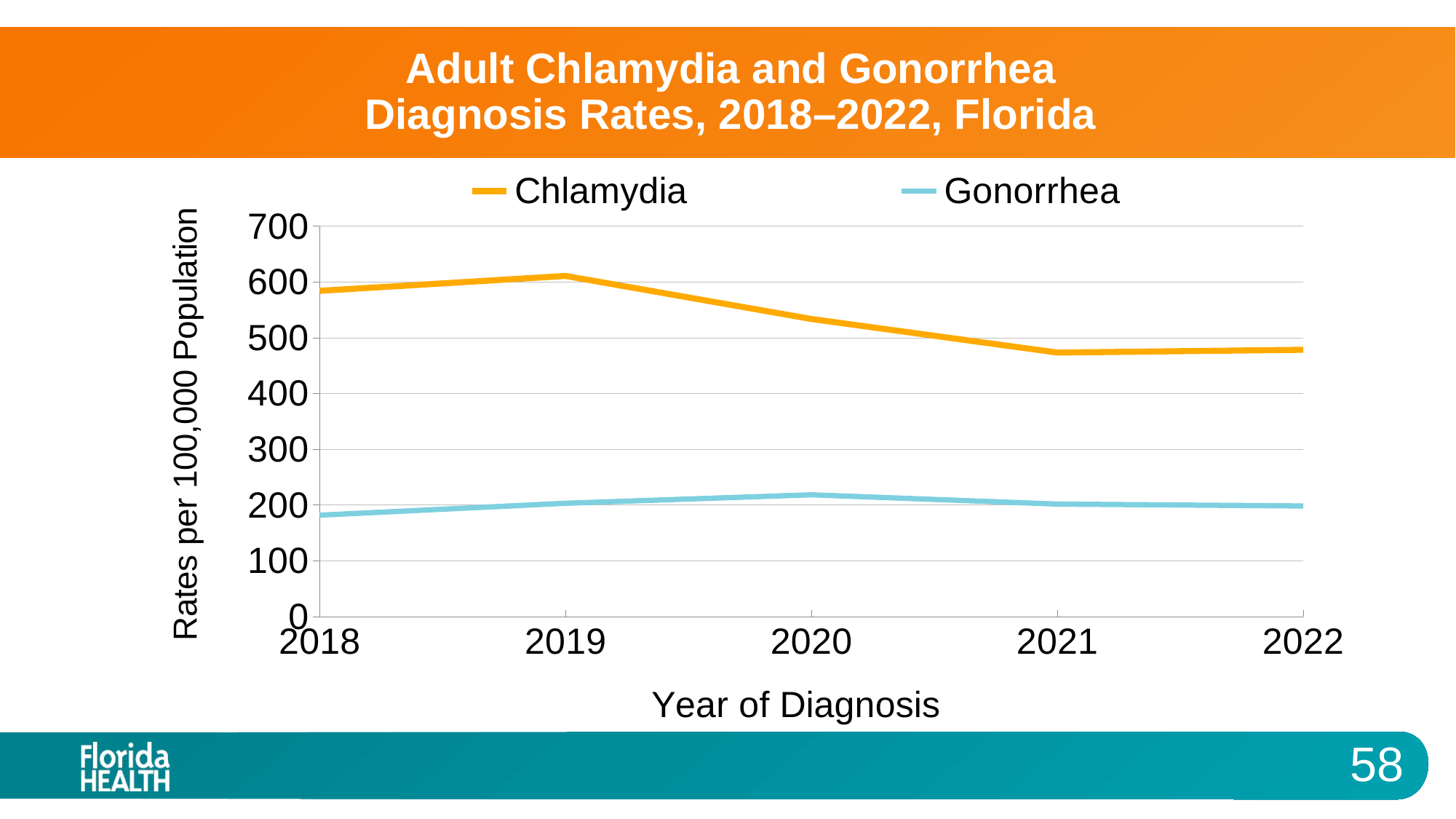
What kind of chart is shown on the slide? line chart In which year is the Gonorrhea diagnosis rate highest? 2020 In which year is the Chlamydia diagnosis rate highest? 2019 Which series has the higher rate in 2020, Chlamydia or Gonorrhea? Chlamydia Is the Gonorrhea rate in 2018 greater or less than 200? less Does the Chlamydia rate rise or fall from 2019 to 2021? fall Is the Chlamydia rate in 2019 greater or less than 600? greater How many series does the legend list? 2 Is the Chlamydia rate in 2021 greater or less than 500? less What is the label of the y axis? Rates per 100,000 Population In which year is the Gonorrhea diagnosis rate lowest? 2018 How many years are plotted along the x axis? 5